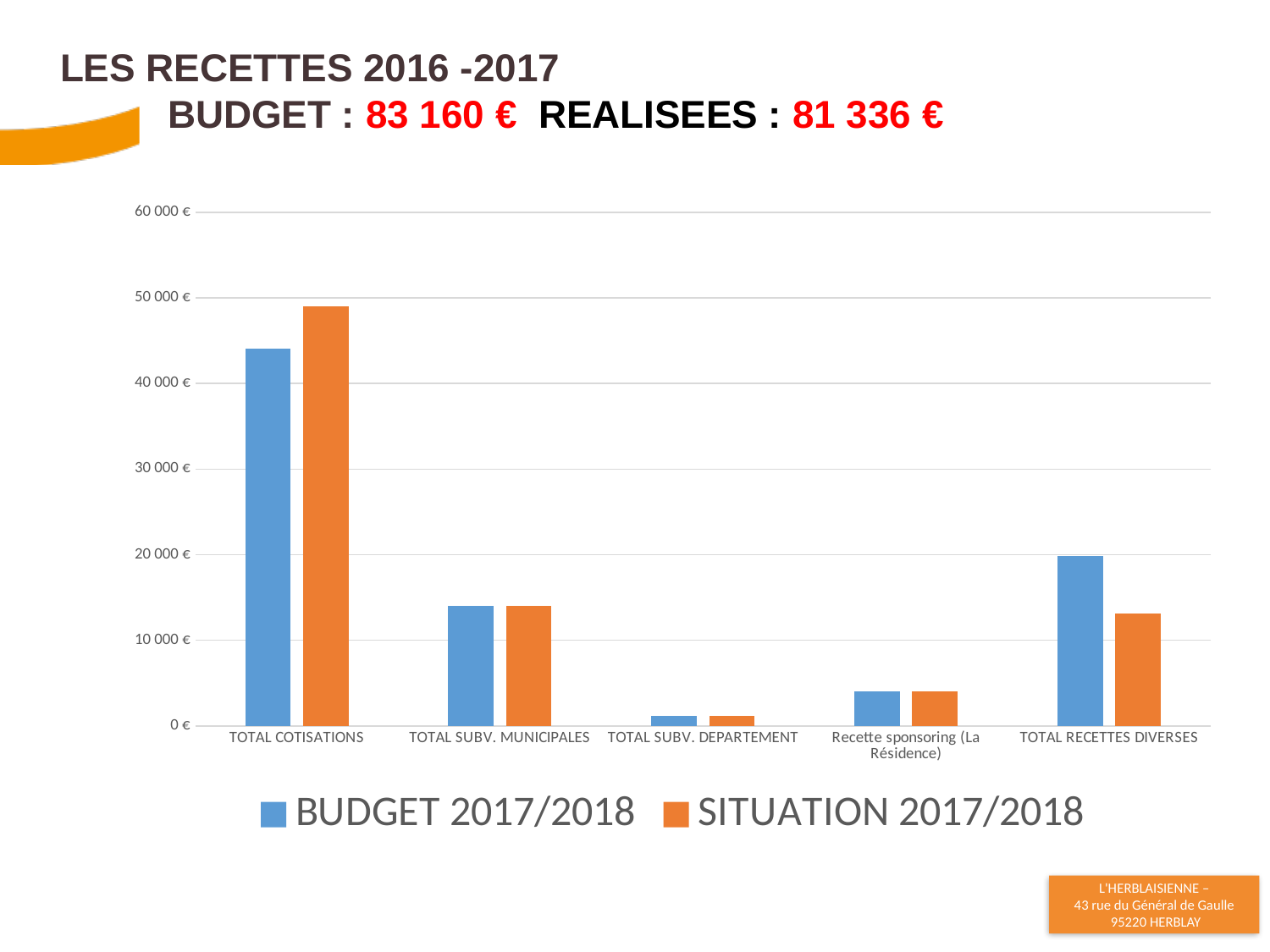
Is the BUDGET 2017/2018 value for TOTAL SUBV. MUNICIPALES greater or less than 20 000 €? less Is the SITUATION 2017/2018 value for TOTAL RECETTES DIVERSES greater or less than 10 000 €? greater Which category has the lowest value for the BUDGET 2017/2018 series? TOTAL SUBV. DEPARTEMENT Which category has the highest value for the SITUATION 2017/2018 series? TOTAL COTISATIONS Is the SITUATION 2017/2018 value for TOTAL SUBV. DEPARTEMENT greater or less than 10 000 €? less For TOTAL COTISATIONS, which series has the larger value, BUDGET 2017/2018 or SITUATION 2017/2018? SITUATION 2017/2018 How many categories are shown on the x axis of the chart? 5 For TOTAL RECETTES DIVERSES, which series has the larger value, BUDGET 2017/2018 or SITUATION 2017/2018? BUDGET 2017/2018 What kind of chart is shown on the slide? bar chart Which colour represents the SITUATION 2017/2018 series in the chart? orange How many series does the chart's legend list? 2